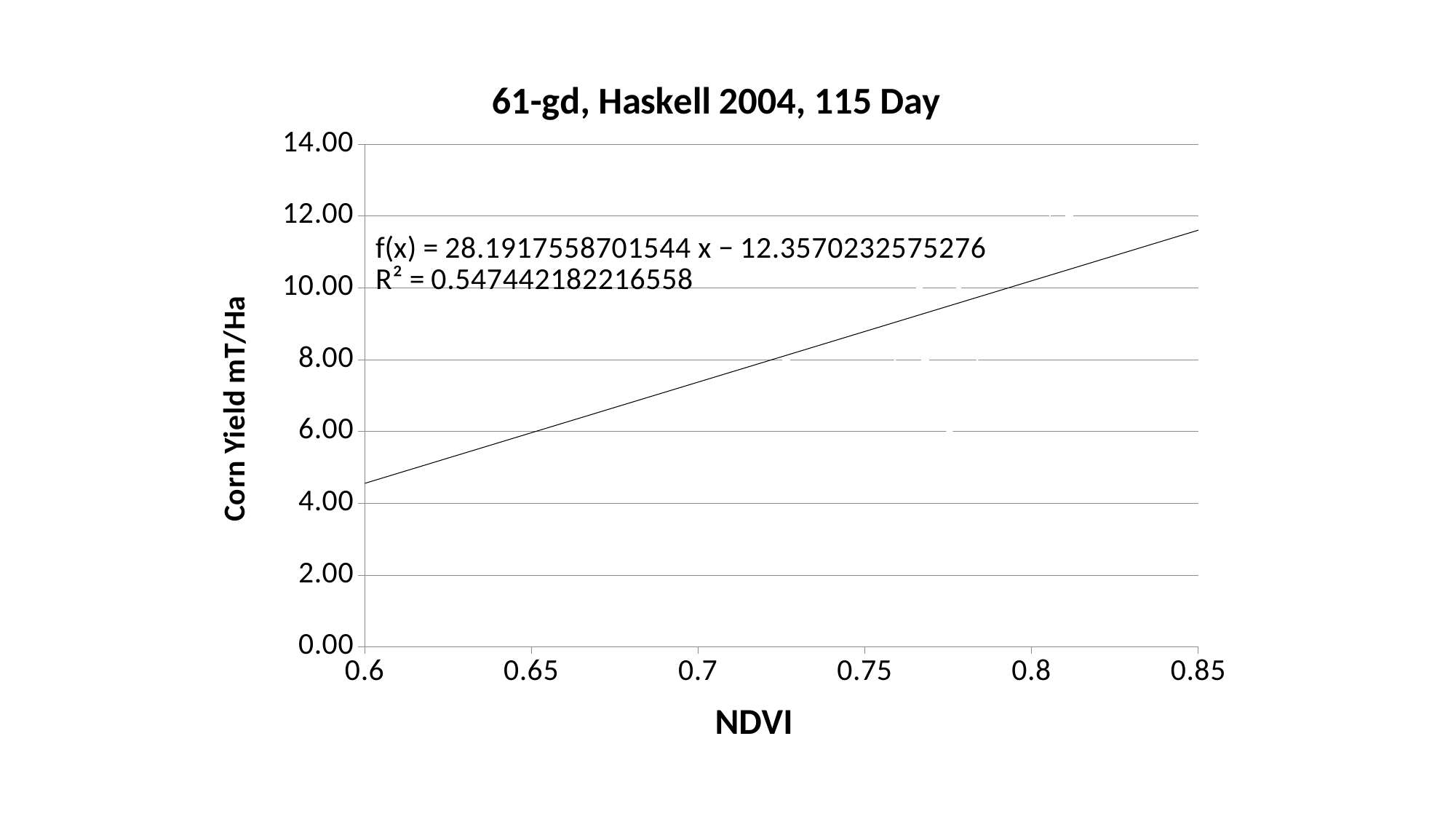
Does the trendline rise or fall as NDVI increases along the x axis? rises Is the trendline value at NDVI 0.8 greater or less than 10.00? greater Is the trendline value at NDVI 0.85 greater or less than 12.00? less What is the maximum value shown on the y axis? 14.00 What is the title of the chart? 61-gd, Haskell 2004, 115 Day Is the trendline value at NDVI 0.7 greater or less than 8.00? less What is the intercept in the fitted equation shown on the chart? −12.3570232575276 What is the label of the y axis? Corn Yield mT/Ha What R² value is printed on the chart? R² = 0.547442182216558 What is the slope coefficient in the fitted equation shown on the chart? 28.1917558701544